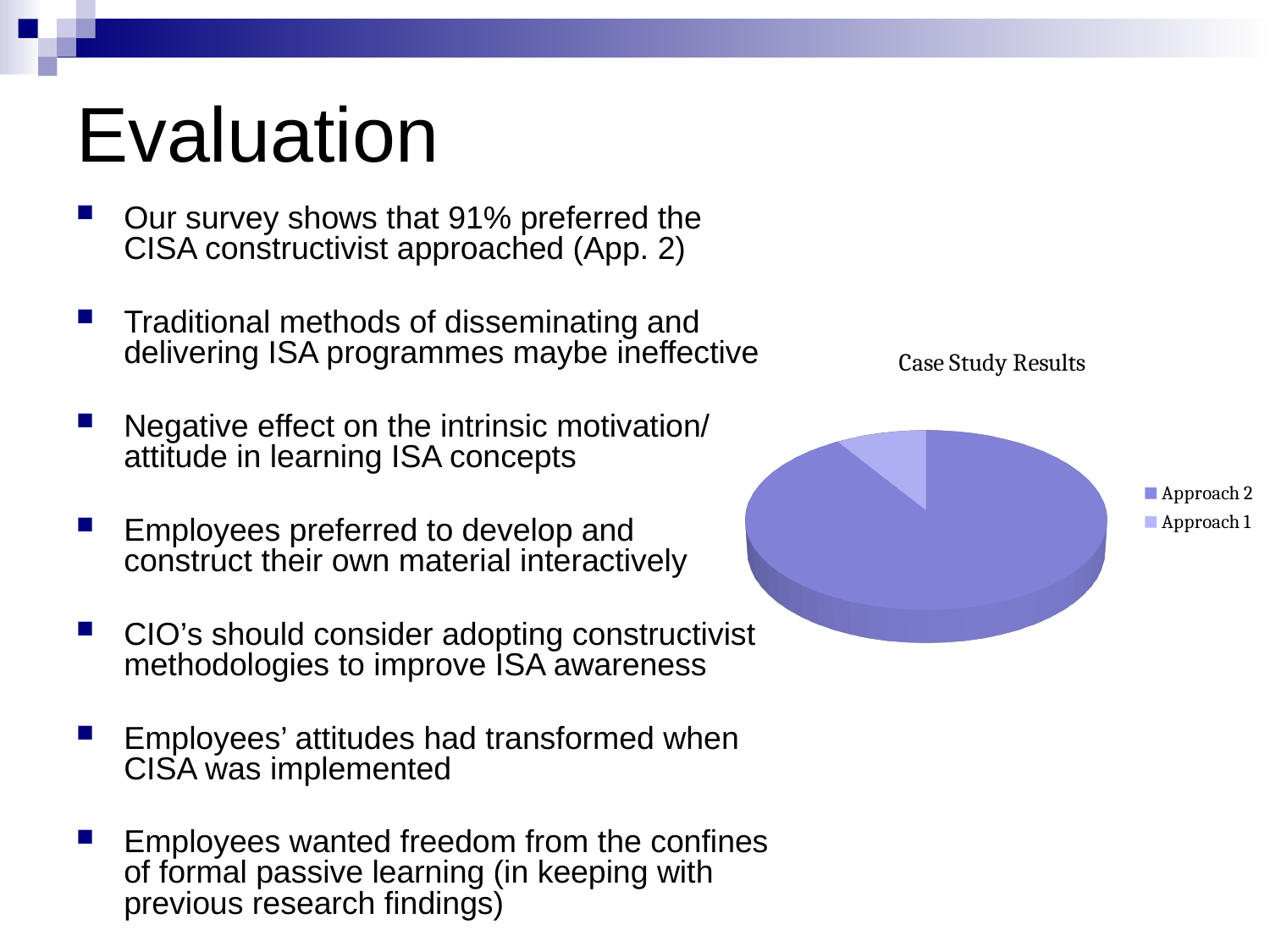
Which approach has the largest slice in the pie chart? Approach 2 Which approach has the smallest slice in the pie chart? Approach 1 How many slices does the pie chart have? 2 What are the two categories listed in the chart legend? Approach 2 and Approach 1 What kind of chart is shown on the slide? pie chart What is the title of the chart? Case Study Results How many entries does the chart legend list? 2 Which slice is larger, Approach 1 or Approach 2? Approach 2